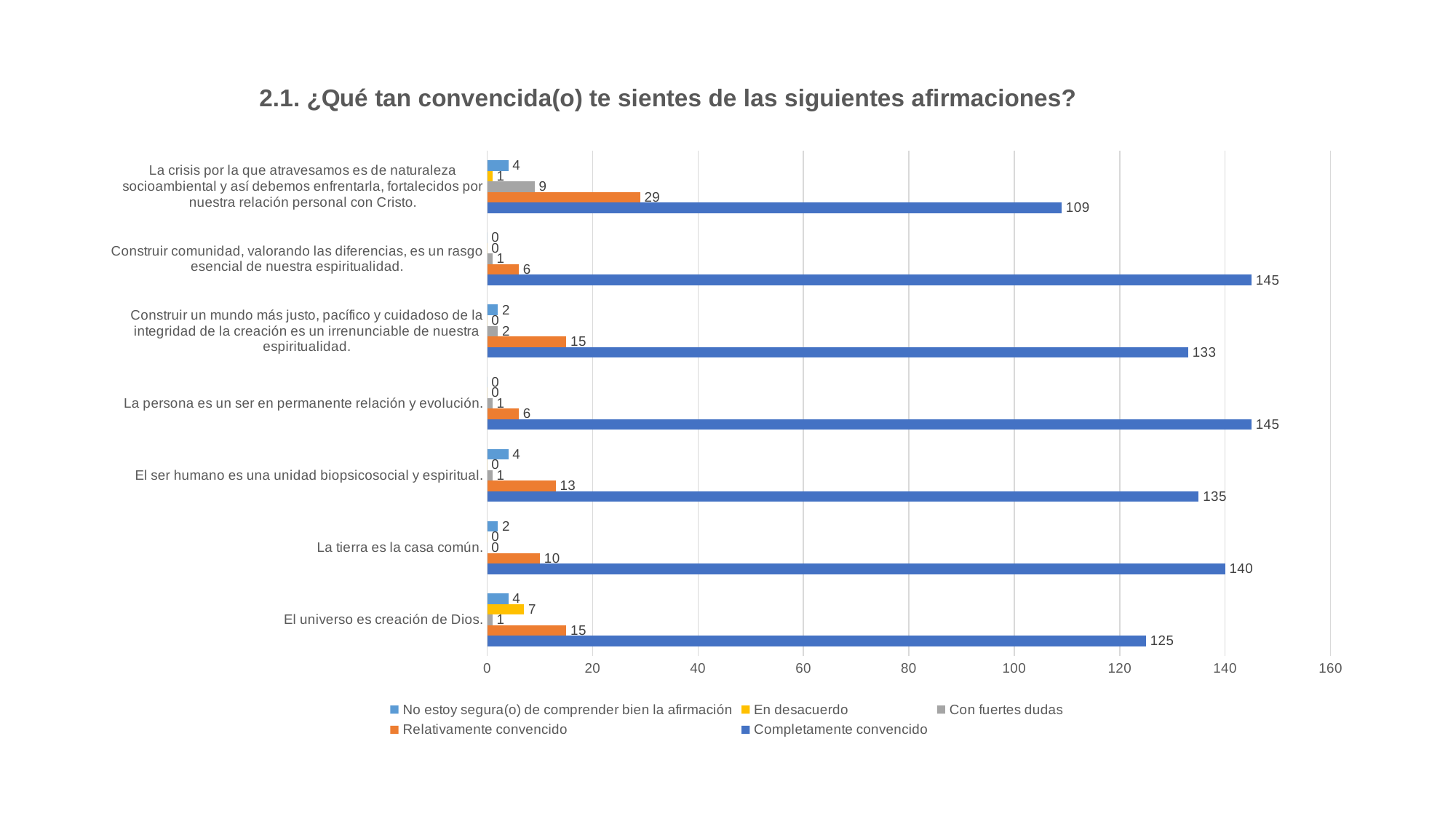
How many series does the legend list? 5 What is the value of "En desacuerdo" for "El universo es creación de Dios."? 7 What is the difference between the "Completamente convencido" values for "La tierra es la casa común." and "El universo es creación de Dios."? 15 How many statements (categories) are shown on the chart? 7 Which statement has the lowest value for "Completamente convencido"? La crisis por la que atravesamos es de naturaleza socioambiental y así debemos enfrentarla, fortalecidos por nuestra relación personal con Cristo. What is the value of "Relativamente convencido" for "La crisis por la que atravesamos es de naturaleza socioambiental y así debemos enfrentarla, fortalecidos por nuestra relación personal con Cristo."? 29 What is the value of "Completamente convencido" for "El universo es creación de Dios."? 125 What kind of chart is shown on the slide? Bar chart What is the title of the chart? 2.1. ¿Qué tan convencida(o) te sientes de las siguientes afirmaciones? Which is larger: the "Completamente convencido" value for "El ser humano es una unidad biopsicosocial y espiritual." or for "Construir un mundo más justo, pacífico y cuidadoso de la integridad de la creación es un irrenunciable de nuestra espiritualidad."? El ser humano es una unidad biopsicosocial y espiritual. Which statement has the highest value for "Relativamente convencido"? La crisis por la que atravesamos es de naturaleza socioambiental y así debemos enfrentarla, fortalecidos por nuestra relación personal con Cristo. What is the value of "Con fuertes dudas" for "La crisis por la que atravesamos es de naturaleza socioambiental y así debemos enfrentarla, fortalecidos por nuestra relación personal con Cristo."? 9